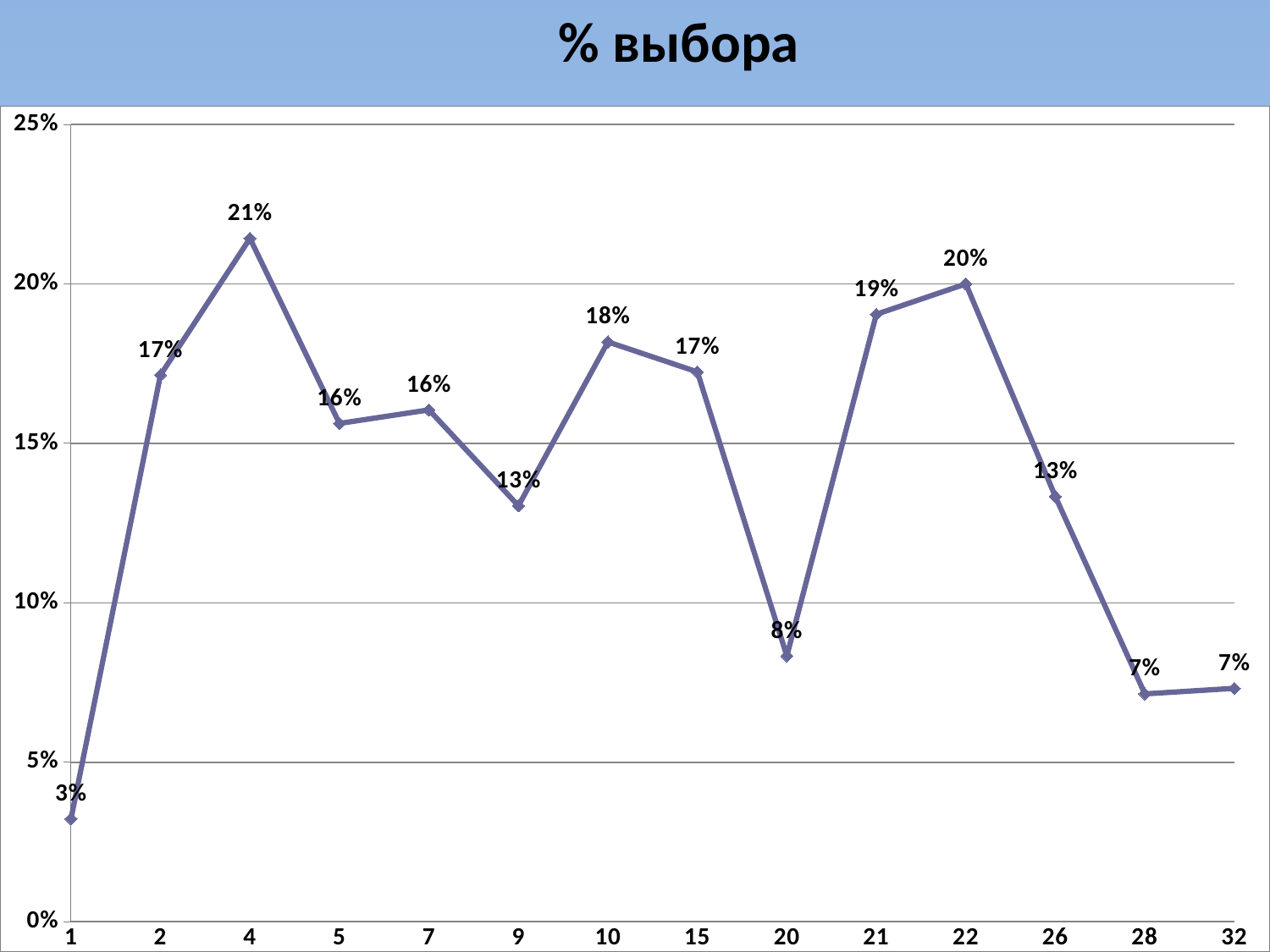
What is the difference between the values for category 4 and category 1? 18% Which category has the highest value? 4 What is the value for category 4? 21% What kind of chart is shown on the slide? line chart Do the values rise or fall from category 22 to category 28? fall Which category has the lowest value? 1 What is the value for category 1? 3% How many data points are plotted on the chart? 14 Which is larger, the value for category 21 or the value for category 26? 21 What is the value for category 20? 8% What is the title of the chart? % выбора Is the value for category 28 greater or less than 10%? less